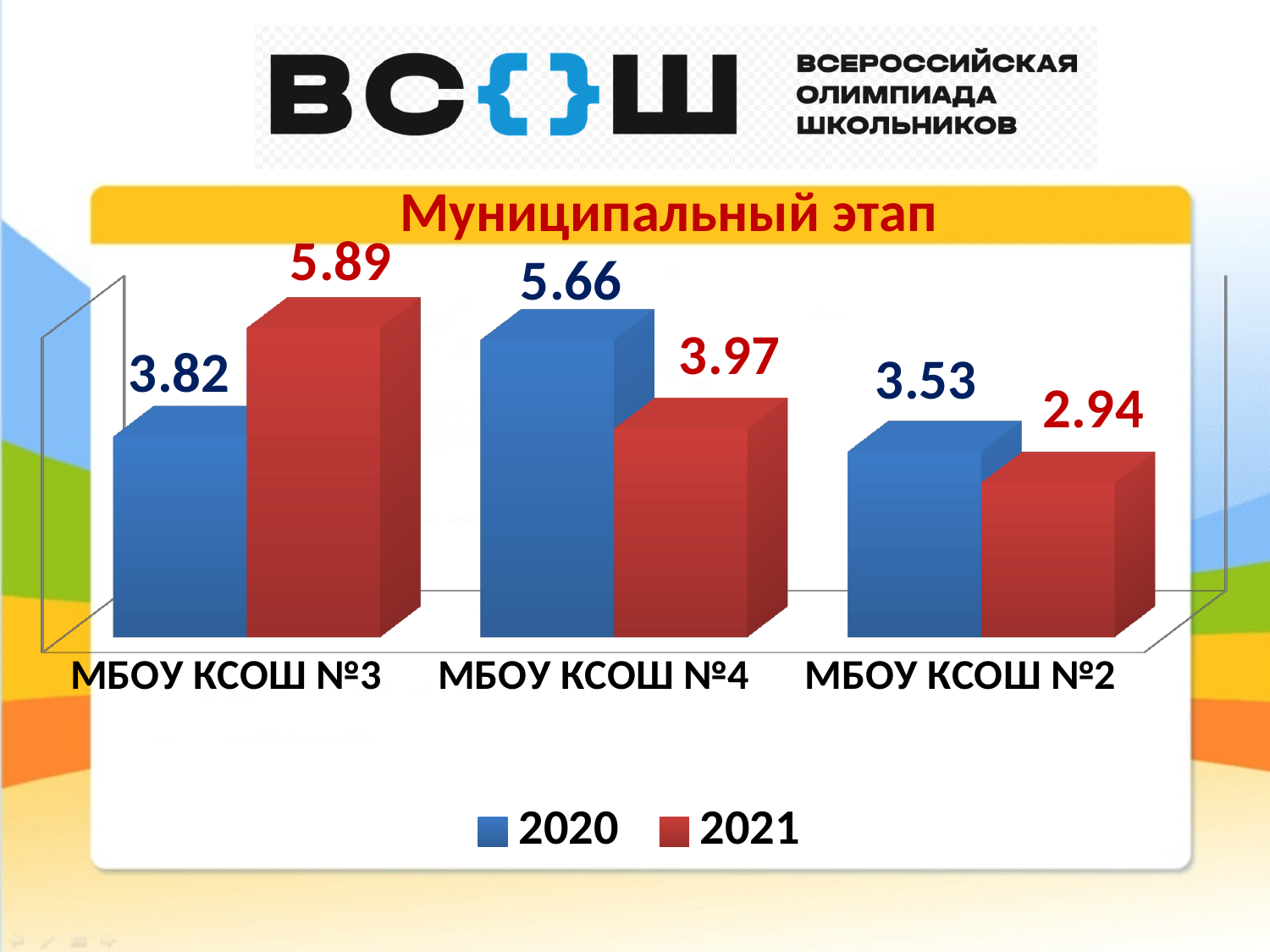
What is the difference between the 2020 and 2021 values for МБОУ КСОШ №4? 1.69 What is the value for МБОУ КСОШ №3 in 2020? 3.82 What is the value for МБОУ КСОШ №3 in 2021? 5.89 Which is larger for МБОУ КСОШ №2: the 2020 value or the 2021 value? 2020 Which school has the lowest value in 2021? МБОУ КСОШ №2 How many schools are shown on the chart? 3 Which school has the highest value in 2020? МБОУ КСОШ №4 What is the difference between the 2021 and 2020 values for МБОУ КСОШ №3? 2.07 What kind of chart is shown on the slide? Bar chart What is the value for МБОУ КСОШ №4 in 2020? 5.66 How many series does the legend list? 2 What is the value for МБОУ КСОШ №2 in 2021? 2.94